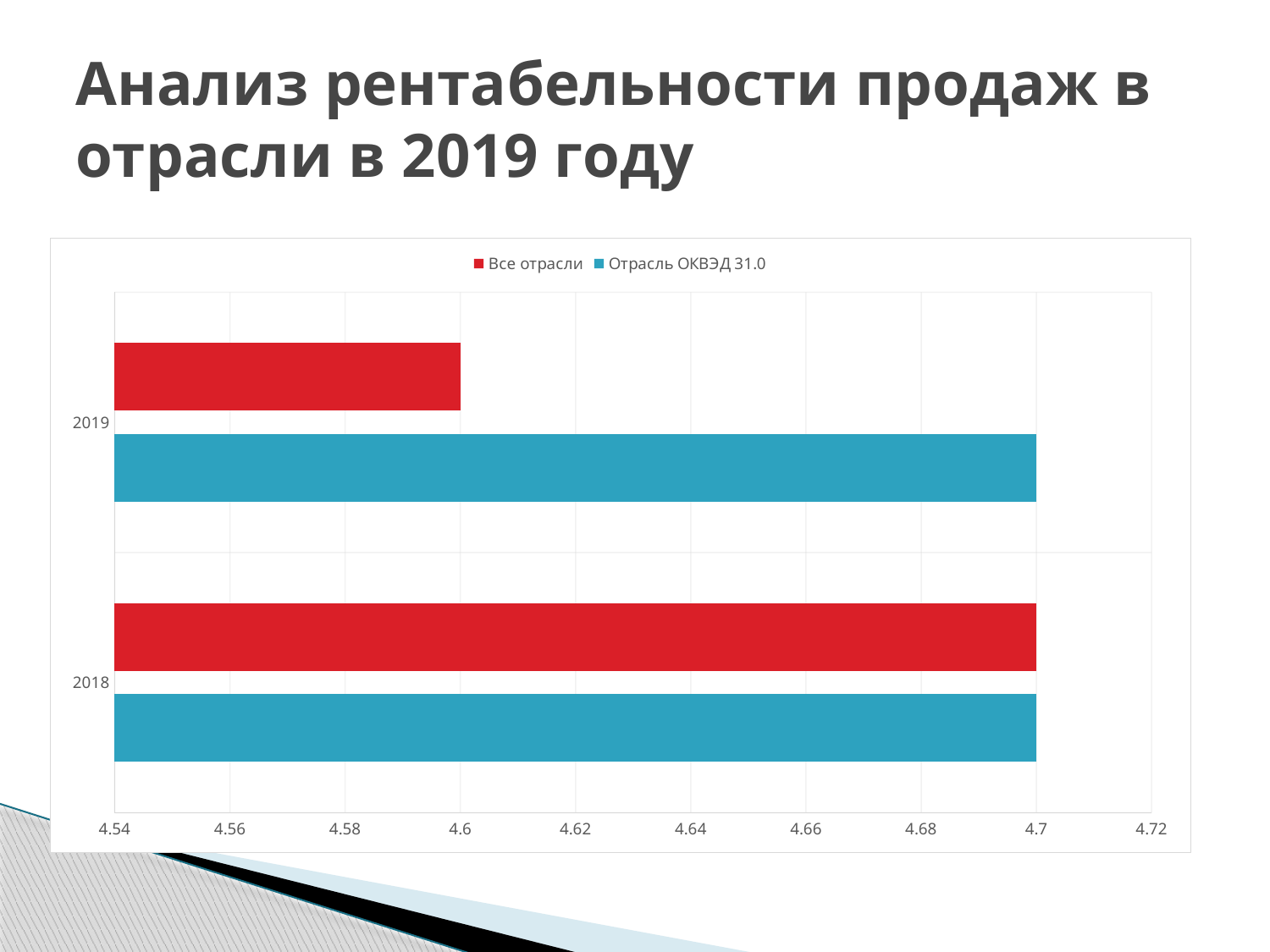
What is the difference between the "Отрасль ОКВЭД 31.0" value and the "Все отрасли" value in 2019? 0.1 How many series does the legend list? 2 What is the value for "Отрасль ОКВЭД 31.0" in 2018? 4.7 What is the value for "Все отрасли" in 2018? 4.7 What is the value for "Все отрасли" in 2019? 4.6 In 2019, which series has the larger value: "Все отрасли" or "Отрасль ОКВЭД 31.0"? Отрасль ОКВЭД 31.0 Is the value for "Все отрасли" in 2019 greater or less than 4.64? less What kind of chart is shown on the slide? bar chart How many years (categories) are shown on the chart? 2 What is the value for "Отрасль ОКВЭД 31.0" in 2019? 4.7 Which colour represents the series "Все отрасли" in the legend? red Did the value for "Все отрасли" rise or fall from 2018 to 2019? fall